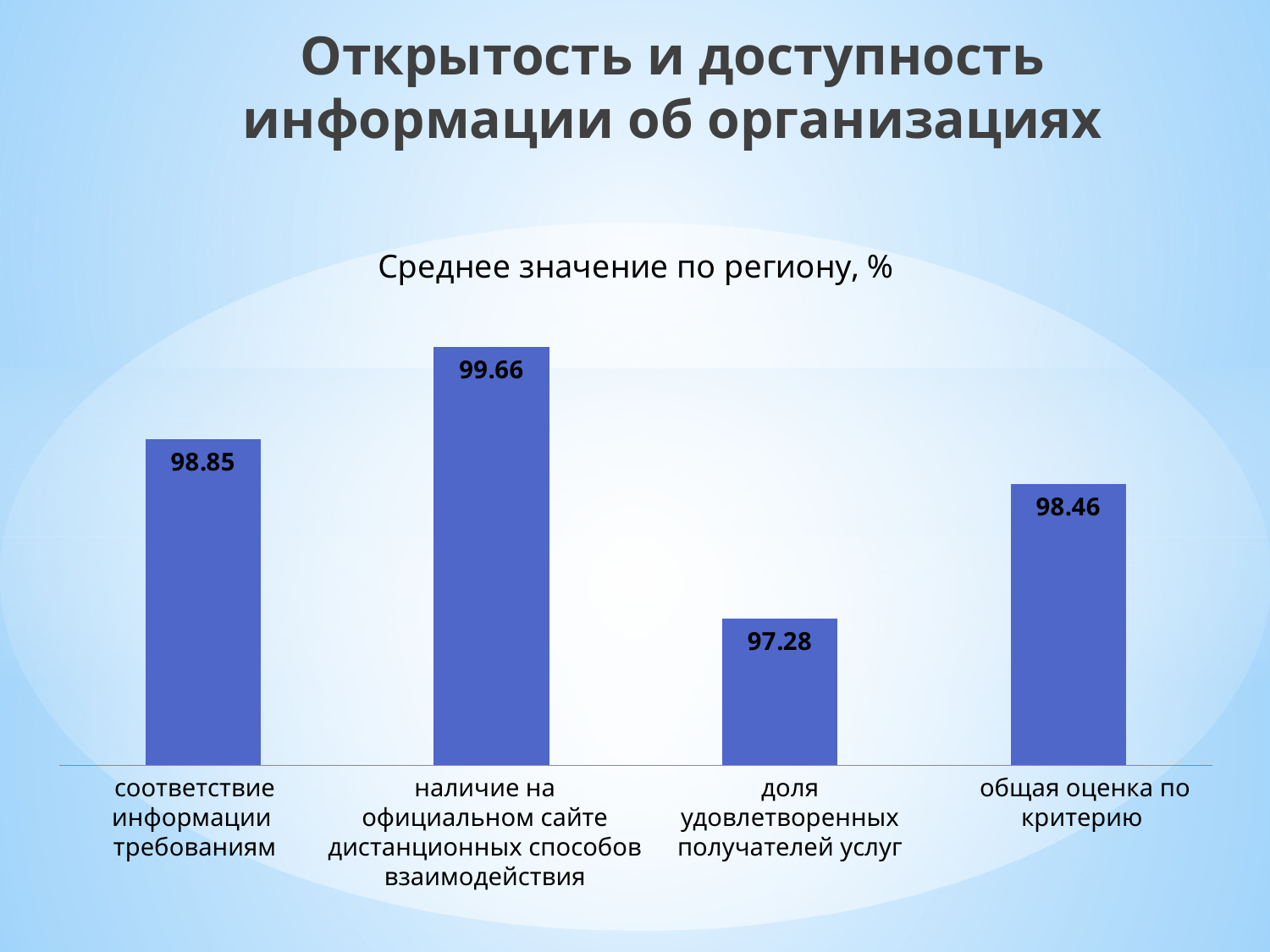
What is the value for "доля удовлетворенных получателей услуг"? 97.28 What is the value for "общая оценка по критерию"? 98.46 What is the title of the chart? Среднее значение по региону, % What is the difference between the values for "наличие на официальном сайте дистанционных способов взаимодействия" and "доля удовлетворенных получателей услуг"? 2.38 What kind of chart is shown on the slide? bar chart What is the difference between the values for "соответствие информации требованиям" and "общая оценка по критерию"? 0.39 What is the value for "соответствие информации требованиям"? 98.85 Which category has the highest value? наличие на официальном сайте дистанционных способов взаимодействия Which category has the lowest value? доля удовлетворенных получателей услуг What is the value for "наличие на официальном сайте дистанционных способов взаимодействия"? 99.66 How many categories are shown in the chart? 4 Which is larger: the value for "соответствие информации требованиям" or the value for "общая оценка по критерию"? соответствие информации требованиям